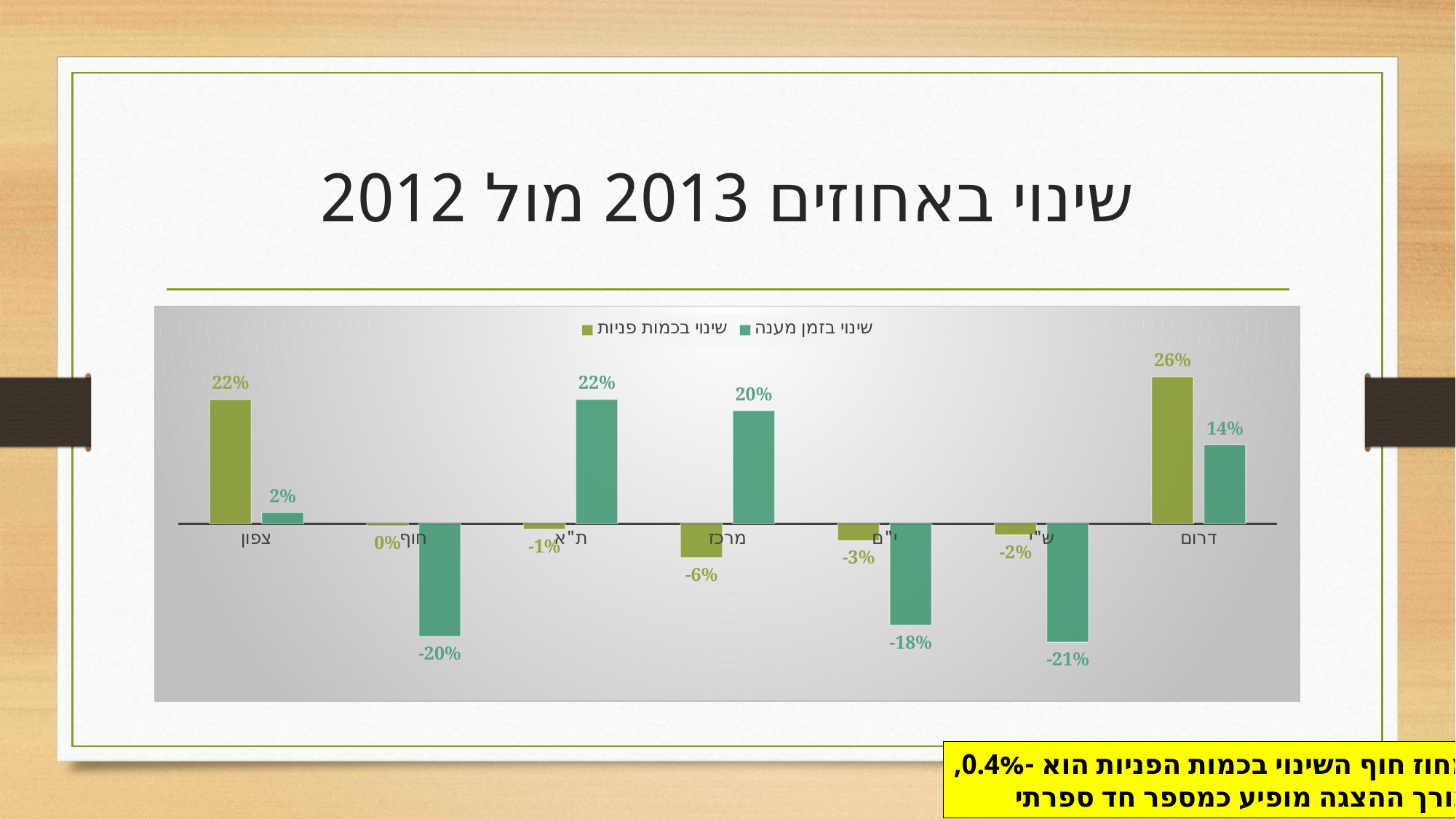
What is the value of שינוי בזמן מענה for מרכז? 20% What is the value of שינוי בכמות פניות for דרום? 26% How many series does the legend list? 2 What is the difference between the שינוי בכמות פניות values for דרום and צפון? 4% What is the value of שינוי בכמות פניות for מרכז? -6% How many categories are shown on the x axis? 7 What is the value of שינוי בזמן מענה for ש"י? -21% Which category has the lowest value for שינוי בזמן מענה? ש"י What kind of chart is shown on the slide? bar chart What is the title of the slide? שינוי באחוזים 2013 מול 2012 Which category has the highest value for שינוי בכמות פניות? דרום Which is larger for ת"א: שינוי בכמות פניות or שינוי בזמן מענה? שינוי בזמן מענה